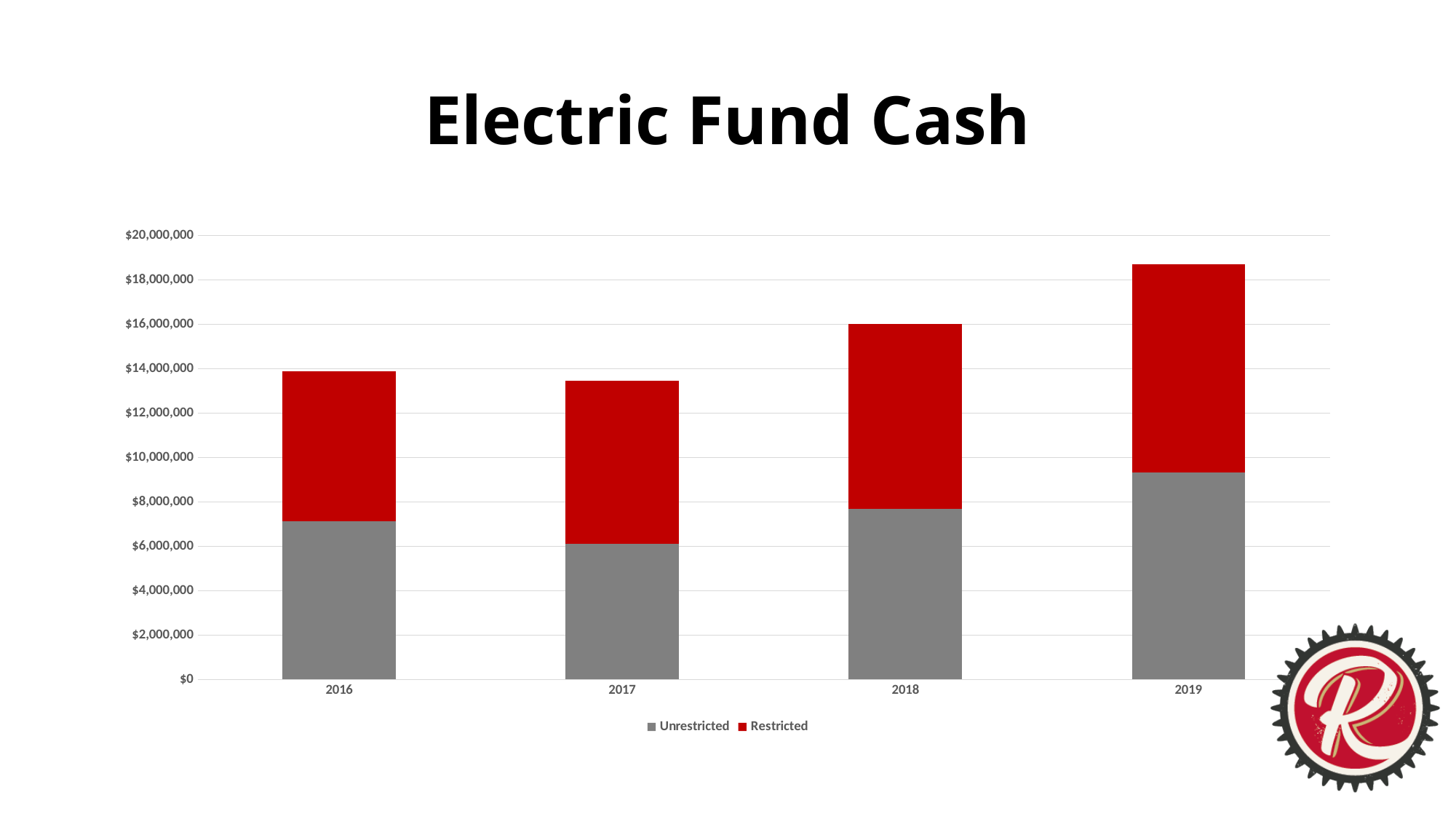
Is the Unrestricted cash for 2018 greater or less than $8,000,000? less Is the total Electric Fund Cash for 2019 greater or less than $18,000,000? greater What colour represents the Restricted series in the chart? red Which year has the lowest Unrestricted cash? 2017 How many years are shown on the x axis of the chart? 4 Which year has the larger total Electric Fund Cash, 2017 or 2018? 2018 Is the Unrestricted cash for 2016 greater or less than $8,000,000? less Which year has the highest total Electric Fund Cash? 2019 How many series does the legend list? 2 What kind of chart is shown on the slide? bar chart Which year has the larger Unrestricted cash, 2016 or 2019? 2019 Which year has the lowest total Electric Fund Cash? 2017